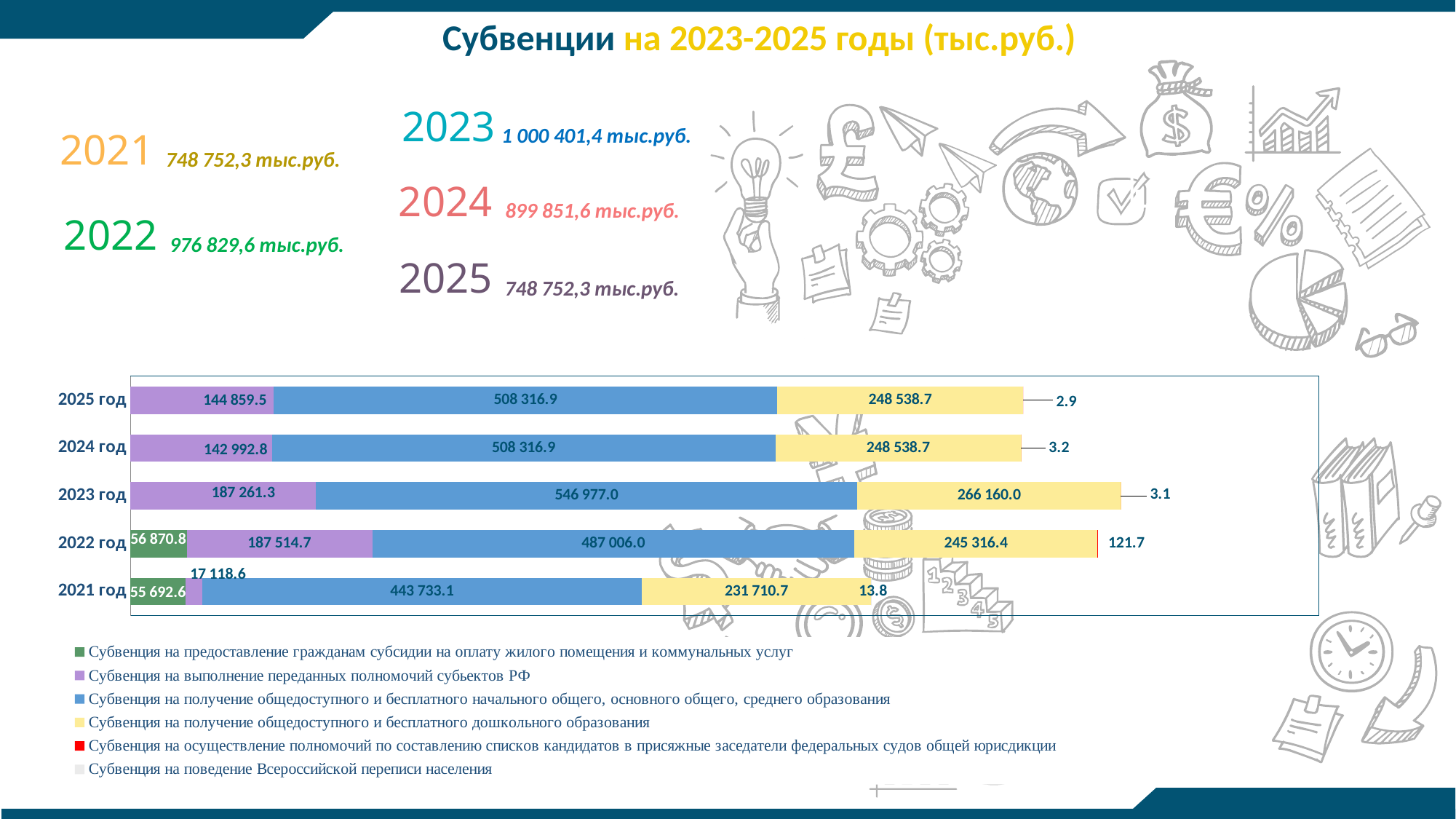
What is the difference between the blue segment for 2023 год and the blue segment for 2024 год? 38 660.1 What is the value of the blue segment (общее образование) for 2023 год? 546 977.0 What colour represents 'Субвенция на получение общедоступного и бесплатного дошкольного образования' in the legend? yellow What is the value of the purple segment (переданные полномочия субъектов РФ) for 2021 год? 17 118.6 Which is larger: the yellow segment for 2022 год or for 2021 год? 2022 год What is the value of the yellow segment (дошкольное образование) for 2025 год? 248 538.7 Which year has the smallest purple segment (переданные полномочия субъектов РФ)? 2021 год What is the value of the green segment (субсидии на оплату жилого помещения) for 2022 год? 56 870.8 Which year has the largest blue segment (общее образование)? 2023 год How many series does the chart legend list? 6 What type of chart is shown on the slide? bar chart How many years (categories) are plotted in the chart? 5